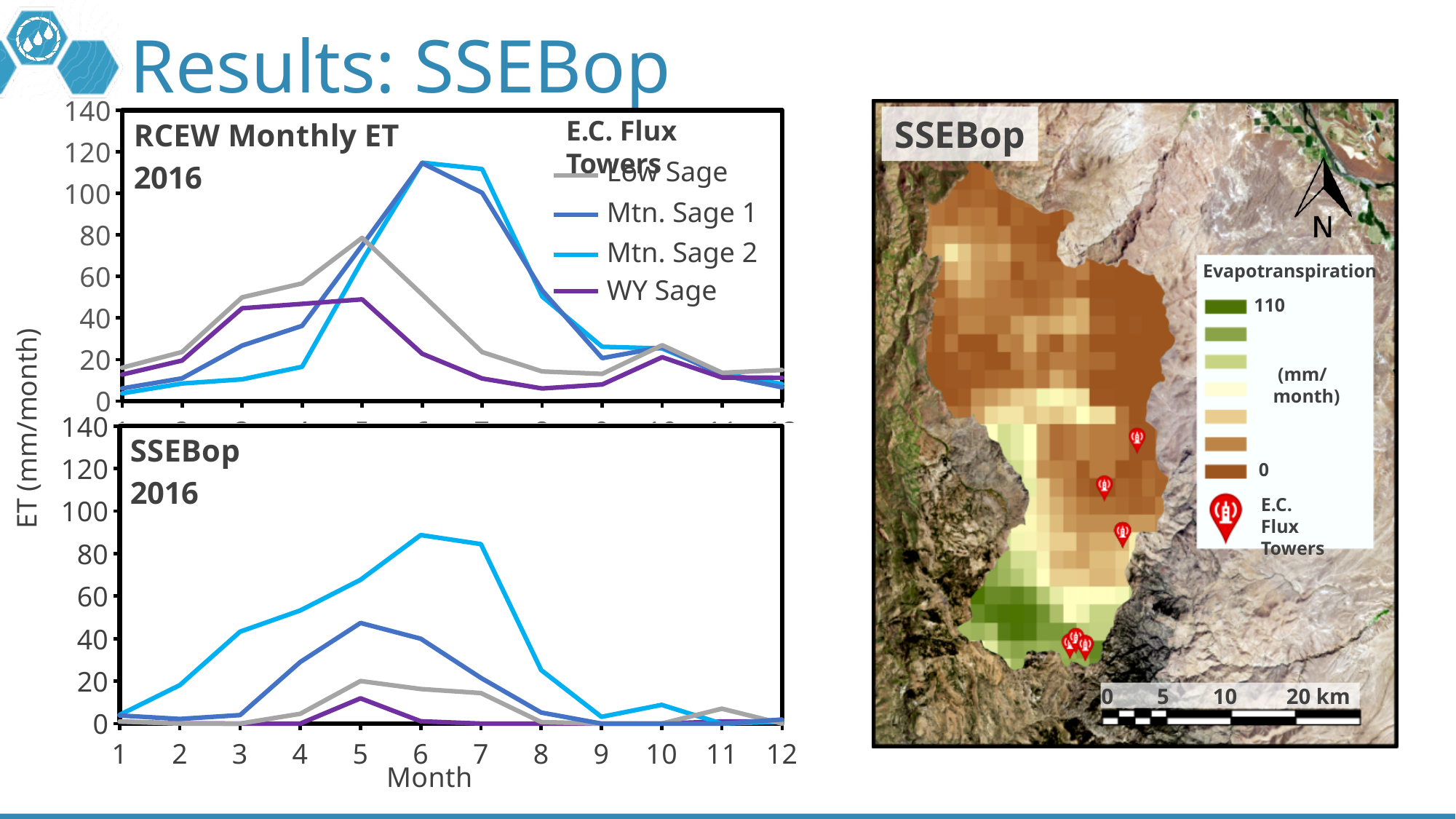
What is the y-axis label shared by the two charts on the left? ET (mm/month) In the top chart "RCEW Monthly ET 2016", which series has the lowest peak value? WY Sage How many months are plotted along the x axis of the bottom chart titled "SSEBop 2016"? 12 In the bottom chart "SSEBop 2016", is the value for Mtn. Sage 2 in month 6 greater or less than 100? less In the top chart "RCEW Monthly ET 2016", which is larger in month 3: Low Sage or Mtn. Sage 2? Low Sage How many series does the legend list for the charts on the left? 4 In the top chart "RCEW Monthly ET 2016", is the value for WY Sage in month 6 greater or less than 40? less In the bottom chart "SSEBop 2016", is the value for Mtn. Sage 1 in month 5 greater or less than 40? greater What type of chart is the top chart titled "RCEW Monthly ET 2016"? line chart In the bottom chart "SSEBop 2016", does the Mtn. Sage 2 line rise or fall from month 7 to month 9? fall In the bottom chart "SSEBop 2016", which series reaches the highest value? Mtn. Sage 2